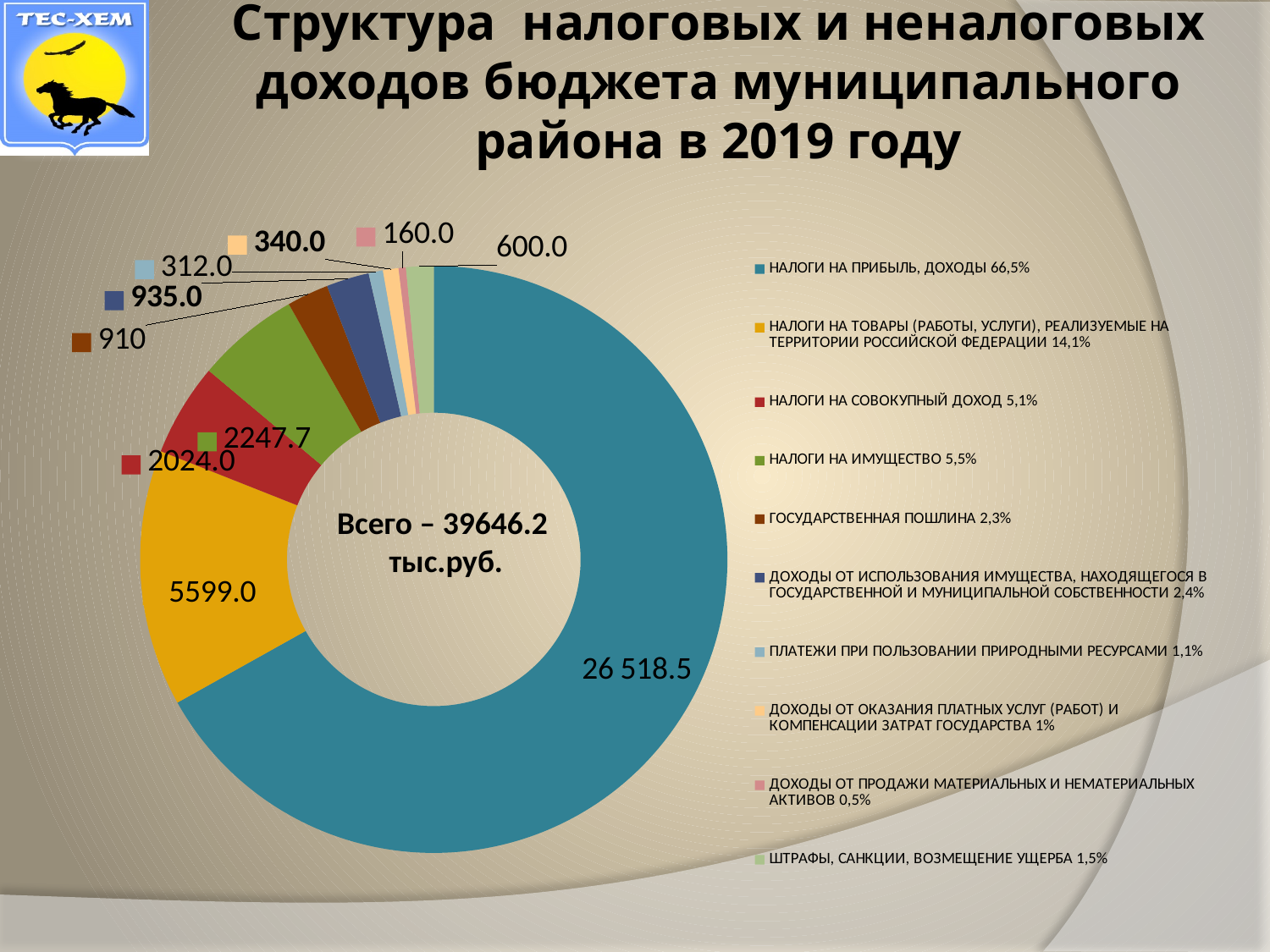
What is the value for НАЛОГИ НА ТОВАРЫ (РАБОТЫ, УСЛУГИ), РЕАЛИЗУЕМЫЕ НА ТЕРРИТОРИИ РОССИЙСКОЙ ФЕДЕРАЦИИ? 5599.0 Which category has the largest slice? НАЛОГИ НА ПРИБЫЛЬ, ДОХОДЫ What total is printed in the centre of the chart? 39646.2 тыс.руб. What is the value for НАЛОГИ НА ПРИБЫЛЬ, ДОХОДЫ? 26 518.5 What kind of chart is shown on the slide? Doughnut (pie) chart Which category has the smallest slice? ДОХОДЫ ОТ ПРОДАЖИ МАТЕРИАЛЬНЫХ И НЕМАТЕРИАЛЬНЫХ АКТИВОВ What is the value for НАЛОГИ НА ИМУЩЕСТВО? 2247.7 Which is larger: the value for НАЛОГИ НА ИМУЩЕСТВО or the value for НАЛОГИ НА СОВОКУПНЫЙ ДОХОД? НАЛОГИ НА ИМУЩЕСТВО How many categories does the legend list? 10 What share of the total does НАЛОГИ НА ПРИБЫЛЬ, ДОХОДЫ represent according to the legend? 66,5% What is the value for ШТРАФЫ, САНКЦИИ, ВОЗМЕЩЕНИЕ УЩЕРБА? 600.0 What is the difference between the values for НАЛОГИ НА ПРИБЫЛЬ, ДОХОДЫ and НАЛОГИ НА ТОВАРЫ (РАБОТЫ, УСЛУГИ)? 20919.5